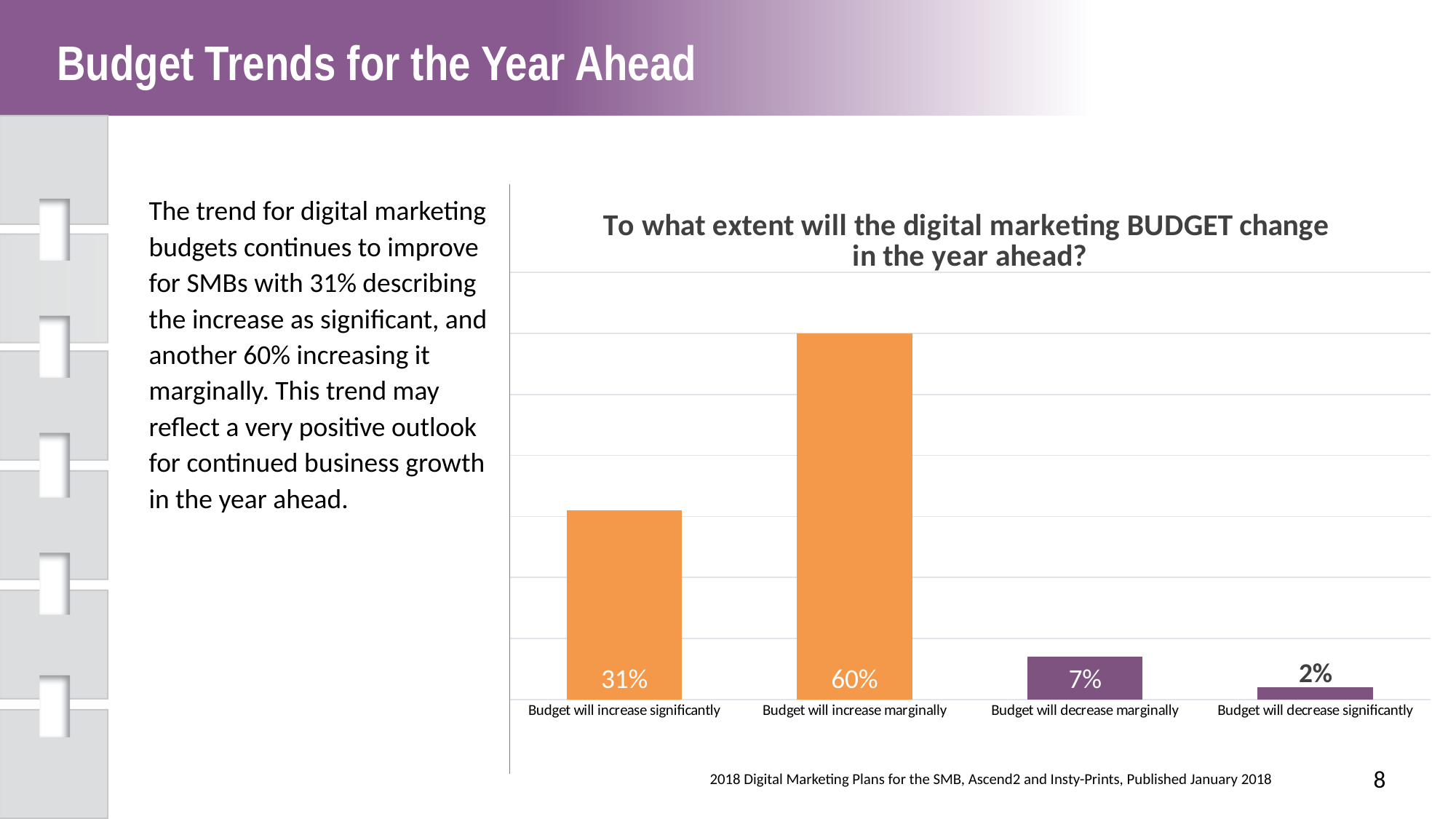
What percentage of respondents say the budget will decrease significantly? 2% Which is larger: the value for 'Budget will increase significantly' or 'Budget will decrease marginally'? Budget will increase significantly What is the difference between the values for 'Budget will decrease marginally' and 'Budget will decrease significantly'? 5% What percentage of respondents say the budget will increase significantly? 31% How many categories are shown in the chart? 4 Which category has the highest value? Budget will increase marginally Which category has the lowest value? Budget will decrease significantly What is the title of the chart? To what extent will the digital marketing BUDGET change in the year ahead? What percentage of respondents say the budget will decrease marginally? 7% What kind of chart is shown on the slide? Bar chart What percentage of respondents say the budget will increase marginally? 60% What is the difference between the values for 'Budget will increase marginally' and 'Budget will increase significantly'? 29%